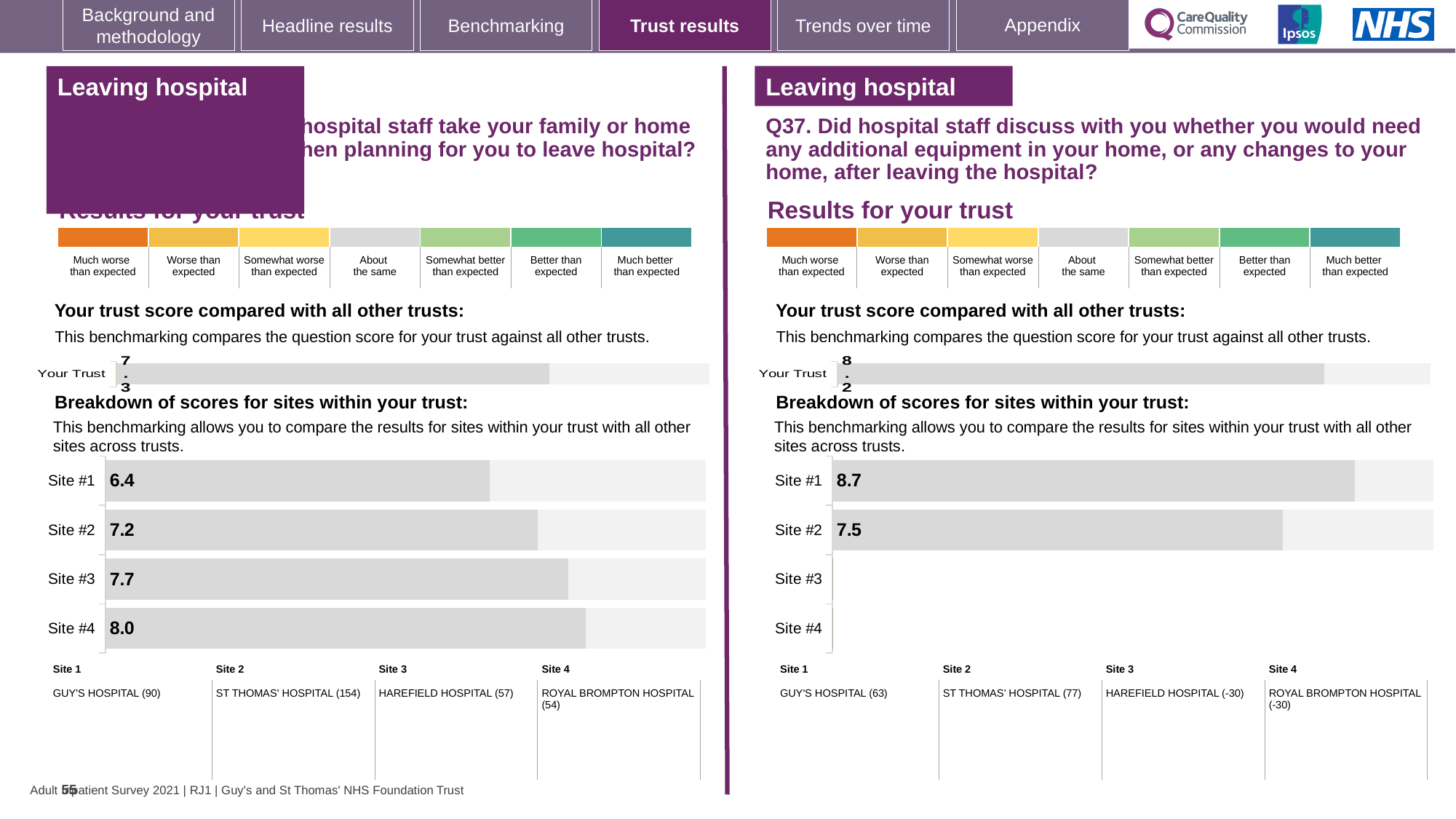
In the right-hand chart for Q37 (breakdown of scores for sites within your trust), what is the score for Site #1? 8.7 In the right-hand chart for Q37, what is the 'Your Trust' score compared with all other trusts? 8.2 In the left-hand chart (breakdown of scores for sites within your trust), what is the difference between the scores for Site #4 and Site #1? 1.6 In the right-hand chart for Q37 (breakdown of scores for sites within your trust), which is larger, the score for Site #1 or Site #2? Site #1 In the right-hand chart for Q37 (breakdown of scores for sites within your trust), what is the difference between the scores for Site #1 and Site #2? 1.2 What kind of chart is used to show the breakdown of scores for sites within your trust on the left-hand side of the slide? Bar chart In the left-hand chart (breakdown of scores for sites within your trust), what is the score for Site #4? 8.0 In the left-hand chart (breakdown of scores for sites within your trust), how many sites are listed? 4 In the right-hand chart for Q37 (breakdown of scores for sites within your trust), what is the score for Site #2? 7.5 In the left-hand chart (breakdown of scores for sites within your trust), which site has the highest score? Site #4 In the left-hand chart (breakdown of scores for sites within your trust), which site has the lowest score? Site #1 In the left-hand chart (breakdown of scores for sites within your trust), what is the score for Site #1? 6.4